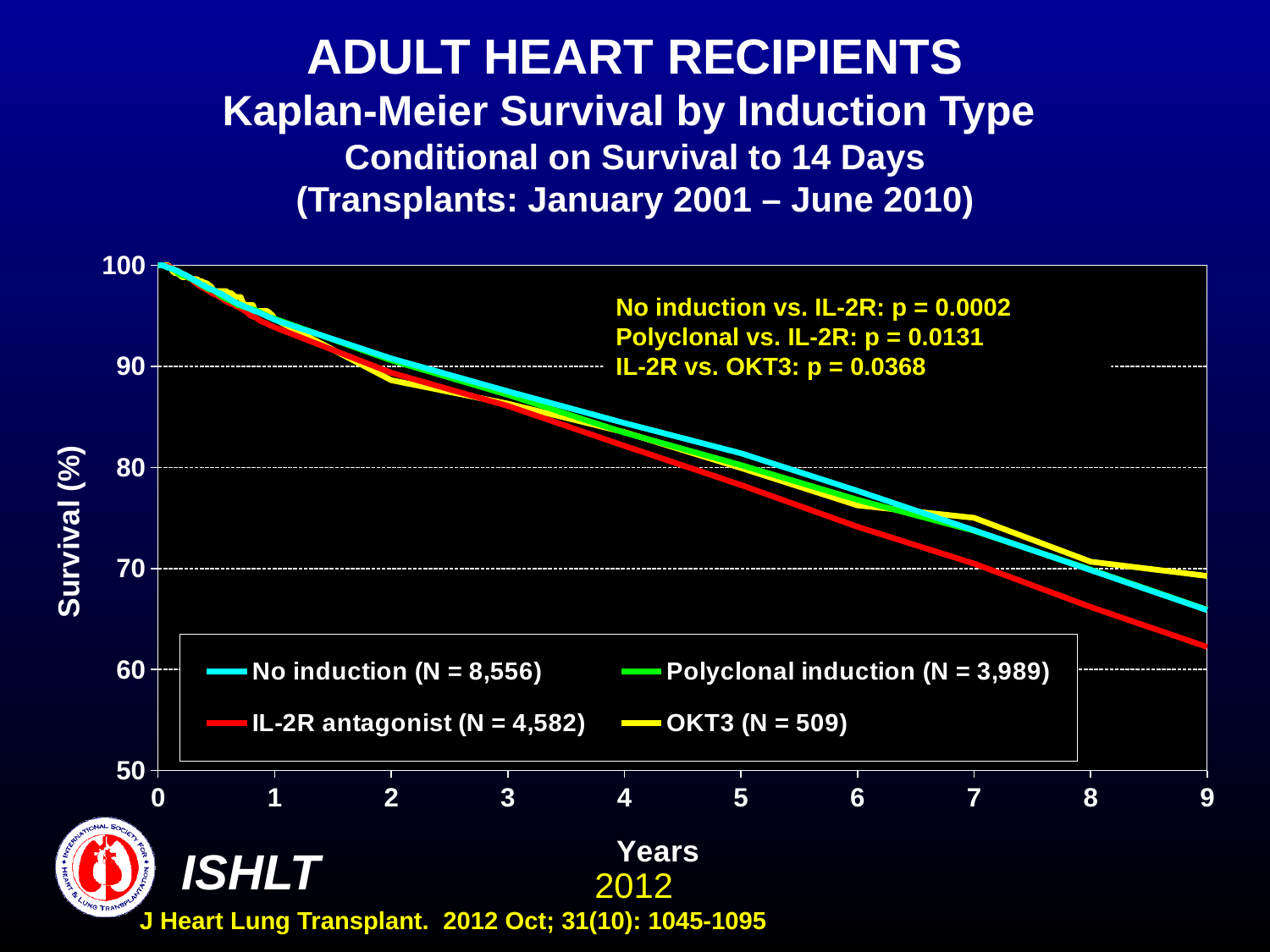
How many series does the legend list? 4 Is the survival for IL-2R antagonist at 9 years greater or less than 70? less Is the survival for Polyclonal induction at 3 years greater or less than 80? greater Which induction type has the lowest survival at 9 years? IL-2R antagonist What is the N for the OKT3 group shown in the legend? 509 What p-value is given for No induction vs. IL-2R? p = 0.0002 Is the survival for No induction at 9 years greater or less than 70? less At 9 years, which is higher: No induction or IL-2R antagonist? No induction What kind of chart is shown on the slide? line chart At 8 years, which is higher: OKT3 or IL-2R antagonist? OKT3 Do the survival curves rise or fall as years increase? fall